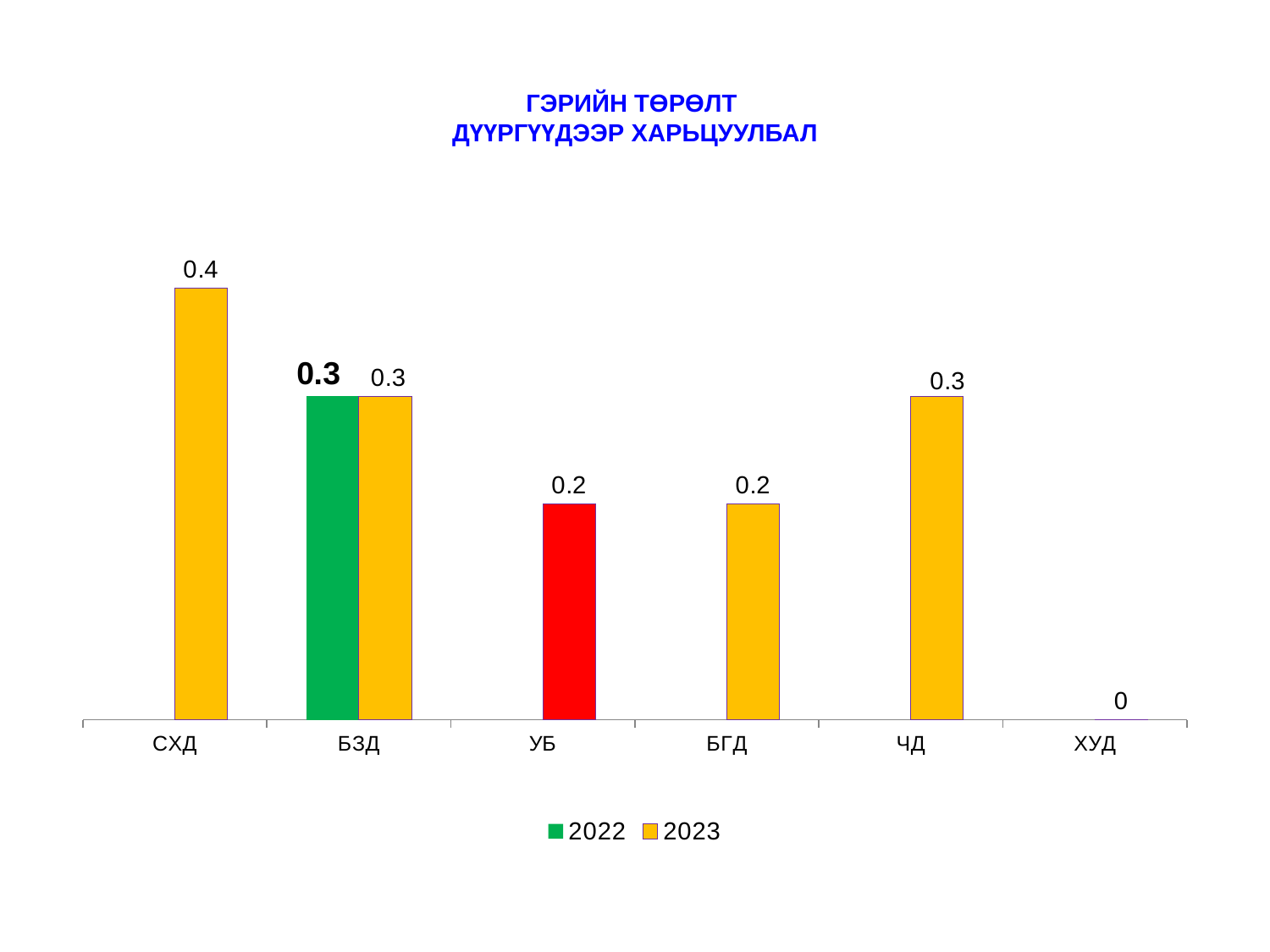
What value is shown for ХУД? 0 How many districts are shown on the x axis? 6 Which district has the lowest value on the chart? ХУД How many series does the legend list? 2 Which district has the highest value on the chart? СХД What is the difference between the 2023 value for СХД and the 2023 value for ЧД? 0.1 What is the 2023 value for ЧД? 0.3 What is the 2022 value for БЗД? 0.3 Which is larger, the 2023 value for СХД or the value for БГД? СХД What is the 2023 value for СХД? 0.4 What kind of chart is shown on the slide? Bar chart What value is shown for БГД? 0.2